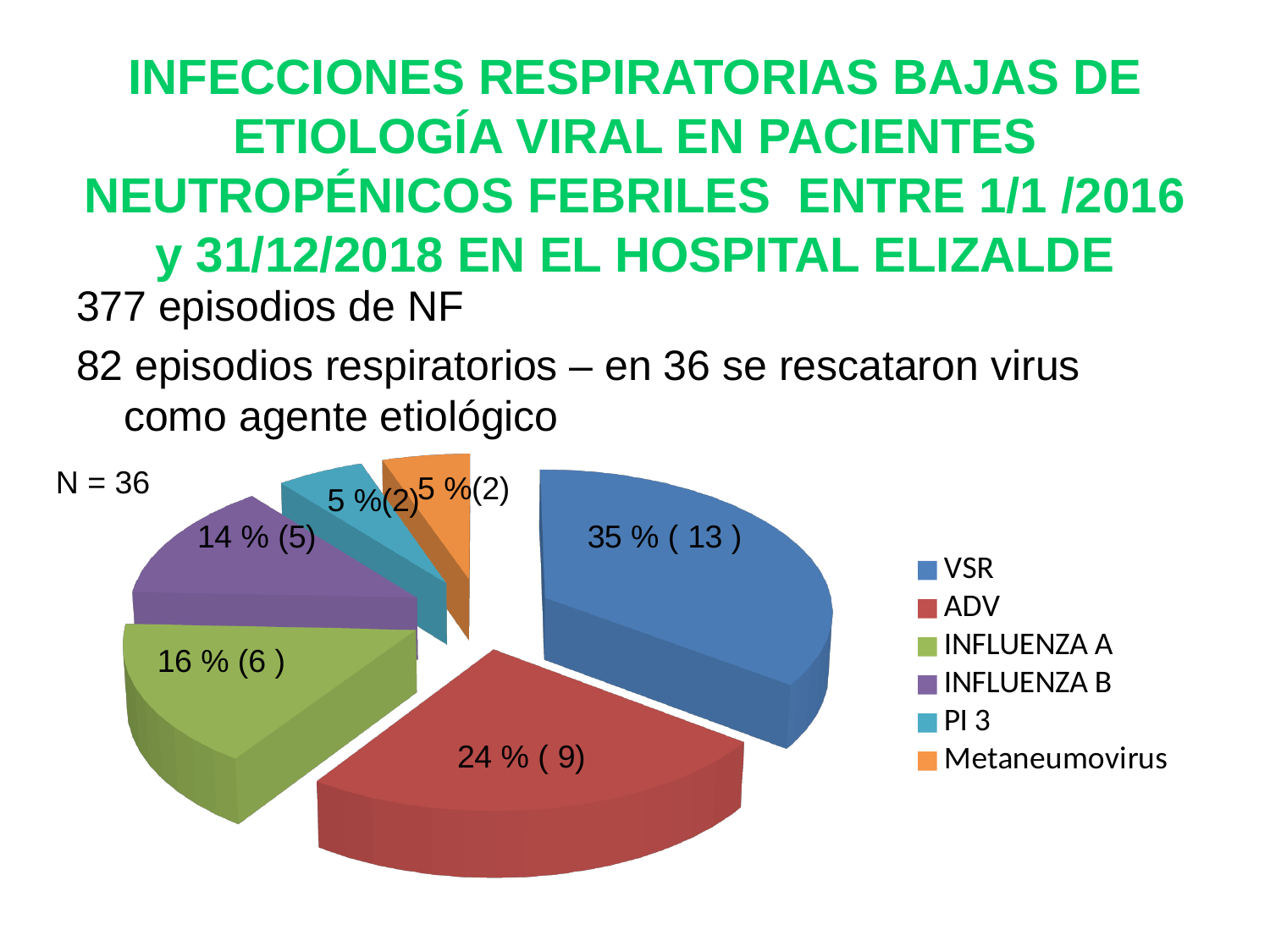
How many categories does the pie chart's legend list? 6 What is the difference in number of cases between VSR and ADV? 4 Which slice is larger, ADV or INFLUENZA A? ADV How many cases are shown for ADV in the pie chart? 9 Which virus has the largest slice of the pie chart? VSR What kind of chart is shown on the slide? pie chart How many cases are shown for INFLUENZA B in the pie chart? 5 What percentage share of the pie does PI 3 have? 5 % What percentage share of the pie does INFLUENZA A have? 16 % What is the total N shown next to the pie chart? N = 36 Which colour represents Metaneumovirus in the pie chart? orange What percentage share of the pie does VSR have? 35 %